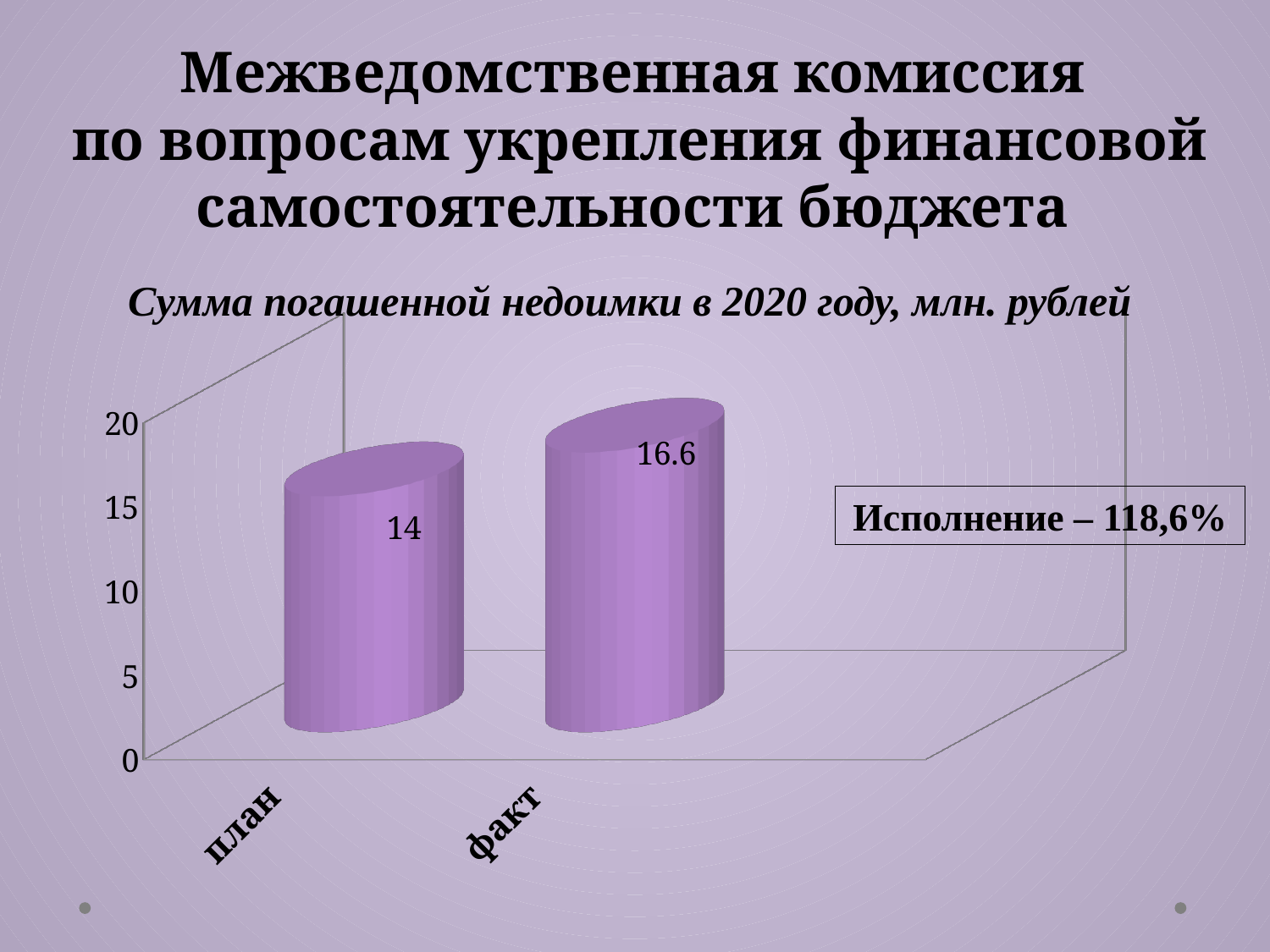
What is the difference between the values for факт and план? 2.6 Which category has the highest value? факт Which category has the lowest value? план How many categories are shown on the x axis? 2 What is the value for план? 14 Is the value for факт greater or less than 15? greater What execution percentage is stated in the text box next to the chart? 118,6% Which is larger, the value for план or the value for факт? факт What kind of chart is shown on the slide? bar chart What is the title of the chart? Сумма погашенной недоимки в 2020 году, млн. рублей Is the value for план greater or less than 15? less What is the value for факт? 16.6